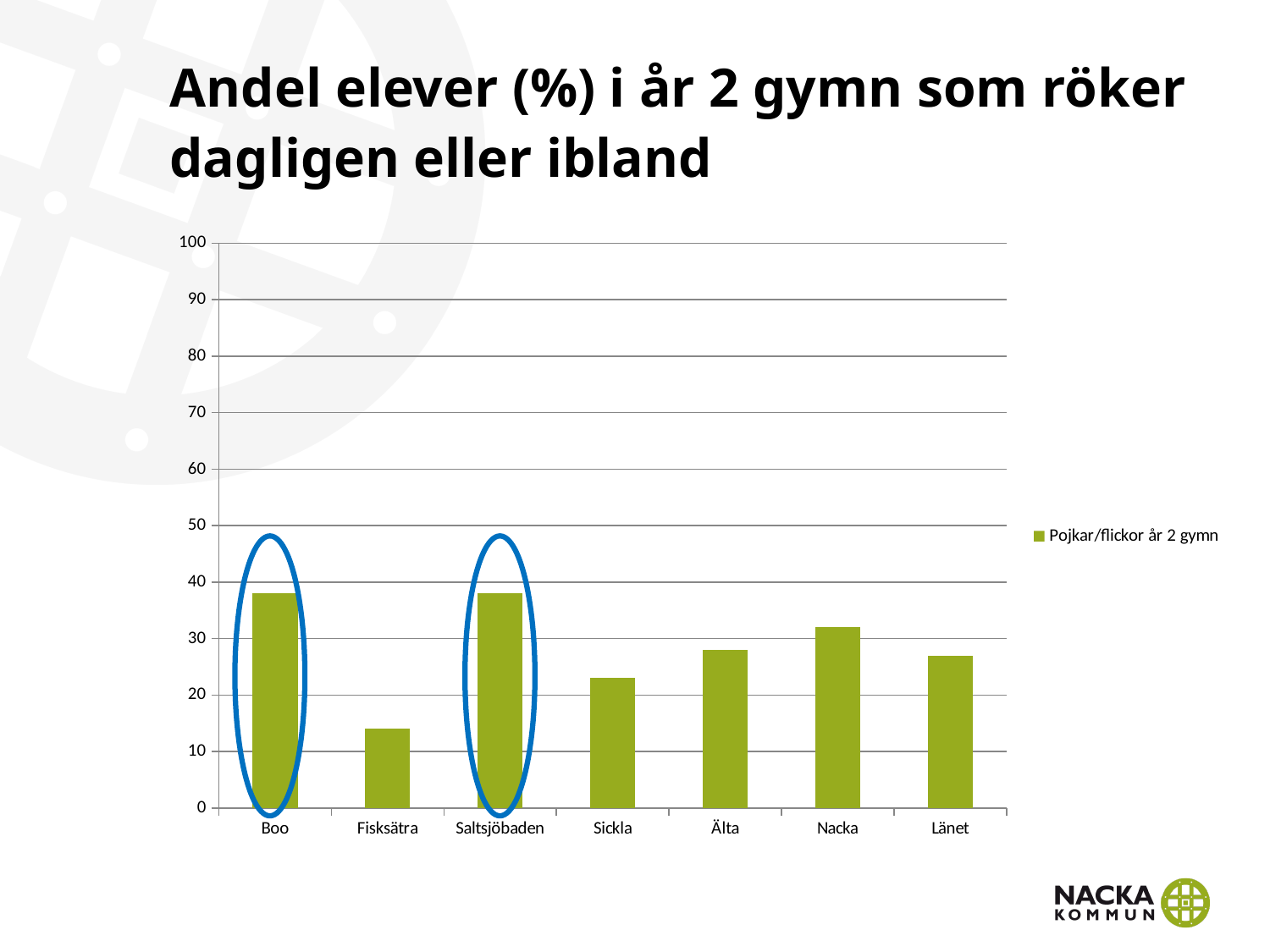
Is the value for Saltsjöbaden greater or less than 40? less How many categories are shown on the x axis of the chart? 7 Is the value for Boo greater or less than 30? greater Is the value for Nacka greater or less than 30? greater Which has a larger value, Nacka or Sickla? Nacka What is the name of the series listed in the legend? Pojkar/flickor år 2 gymn What kind of chart is shown on the slide? bar chart Which category has the lowest value in the chart? Fisksätra Which has a larger value, Fisksätra or Länet? Länet How many series does the legend list? 1